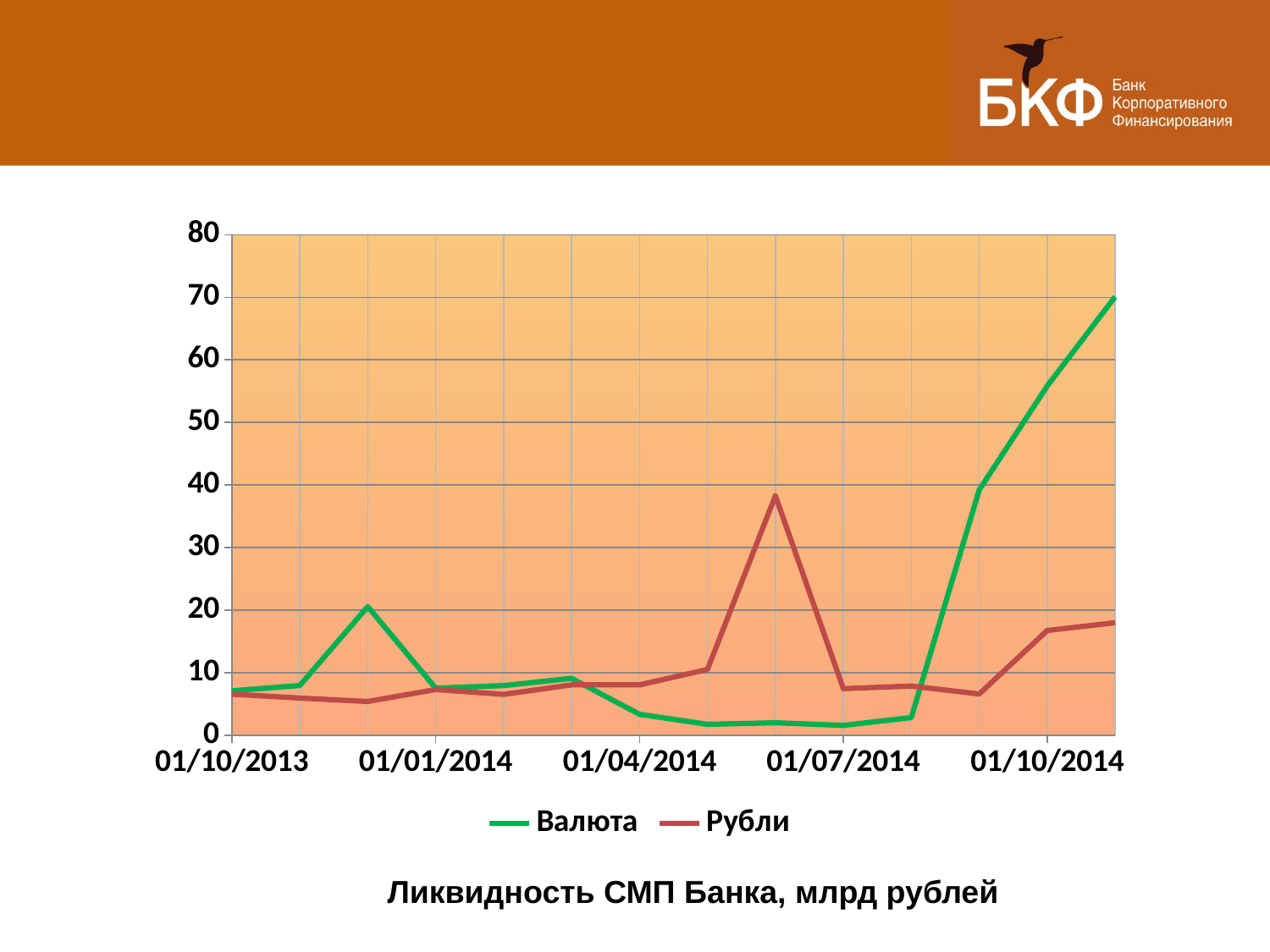
What are the two series named in the legend? Валюта and Рубли Does the Валюта line rise or fall between 01/07/2014 and 01/10/2014? rise How many series does the legend list? 2 Is the value for Рубли at 01/01/2014 greater or less than 10? less Is the value for Валюта at 01/07/2014 greater or less than 10? less At 01/07/2014, which series has the larger value, Валюта or Рубли? Рубли Is the value for Рубли at 01/10/2014 greater or less than 20? less At 01/10/2014, which series has the larger value, Валюта or Рубли? Валюта What kind of chart is shown on the slide? line chart What is the caption of the chart? Ликвидность СМП Банка, млрд рублей How many dates are labelled on the x axis? 5